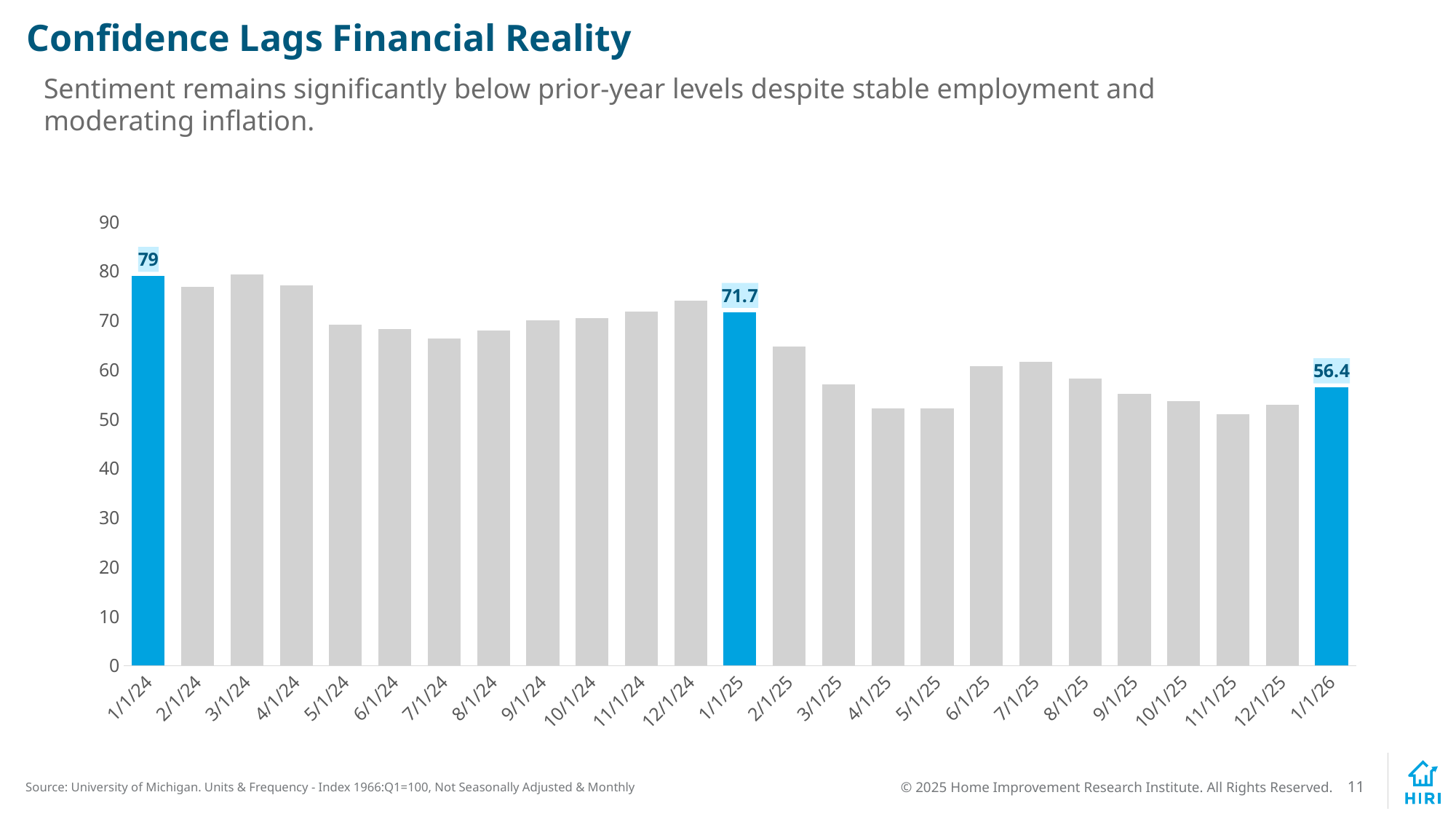
How many bars are shown in the chart? 25 What is the value for 1/1/25? 71.7 What is the value for 1/1/26? 56.4 What is the difference between the values for 1/1/25 and 1/1/26? 15.3 Do the values generally rise or fall from 1/1/24 to 1/1/26? fall What kind of chart is shown on the slide? bar chart What is the value for 1/1/24? 79 Is the value for 11/1/25 greater or less than 60? less What is the difference between the values for 1/1/24 and 1/1/25? 7.3 Which is larger, the value for 1/1/24 or the value for 1/1/26? 1/1/24 Is the value for 7/1/24 greater or less than 70? less Is the value for 2/1/24 greater or less than 70? greater